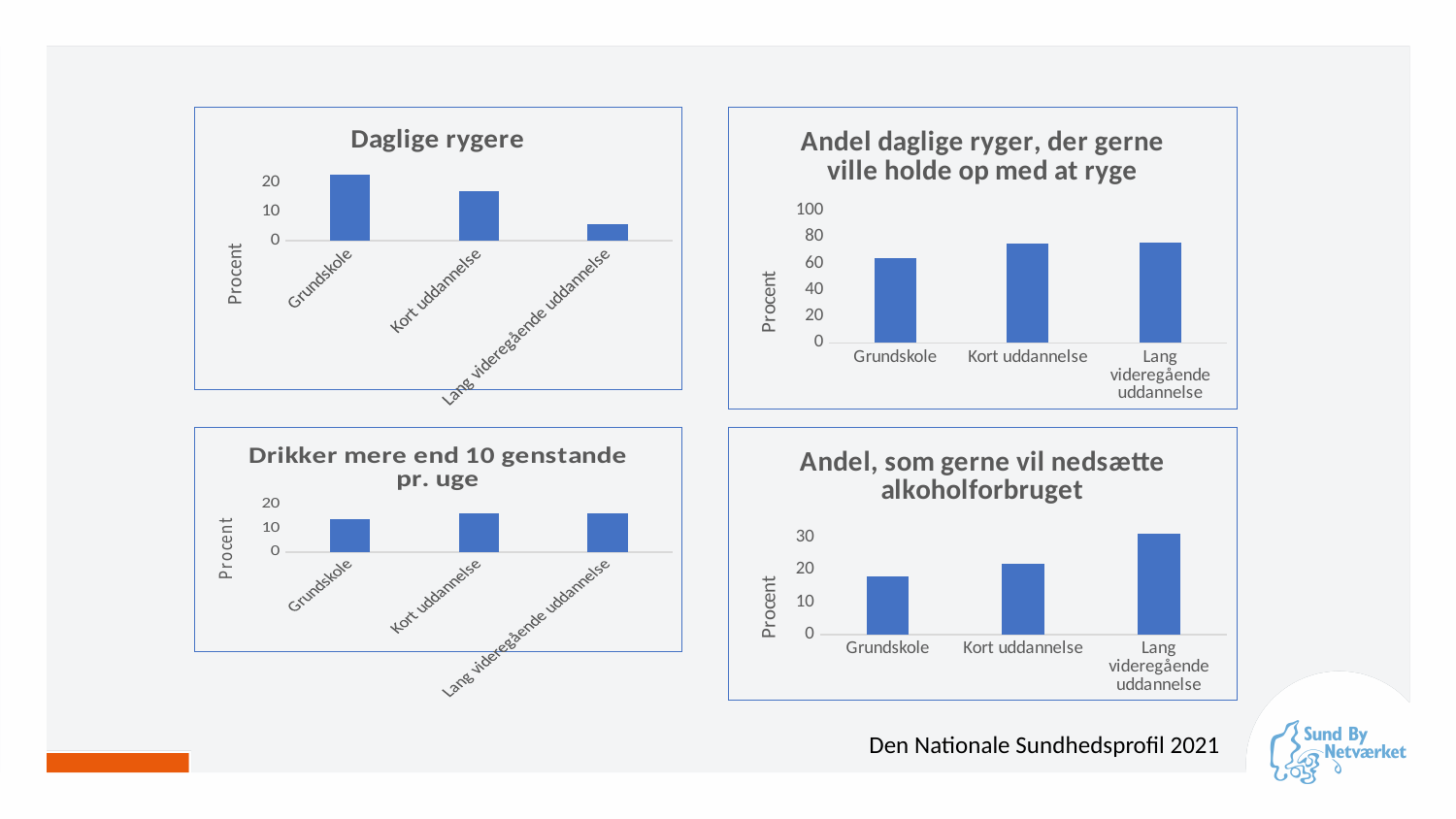
In the 'Andel, som gerne vil nedsætte alkoholforbruget' chart, which category has the highest value? Lang videregående uddannelse What type of chart is the 'Daglige rygere' chart? bar chart In the 'Andel, som gerne vil nedsætte alkoholforbruget' chart, is the value for Grundskole greater or less than 20? less How many categories are shown in the 'Andel, som gerne vil nedsætte alkoholforbruget' chart? 3 In the 'Daglige rygere' chart, which category has the highest value? Grundskole In the 'Daglige rygere' chart, is the value for Lang videregående uddannelse greater or less than 10? less In the 'Andel daglige ryger, der gerne ville holde op med at ryge' chart, is the value for Grundskole greater or less than 80? less In the 'Daglige rygere' chart, which category has the lowest value? Lang videregående uddannelse In the 'Drikker mere end 10 genstande pr. uge' chart, which category has the lowest value? Grundskole In the 'Andel daglige ryger, der gerne ville holde op med at ryge' chart, which category has the lowest value? Grundskole